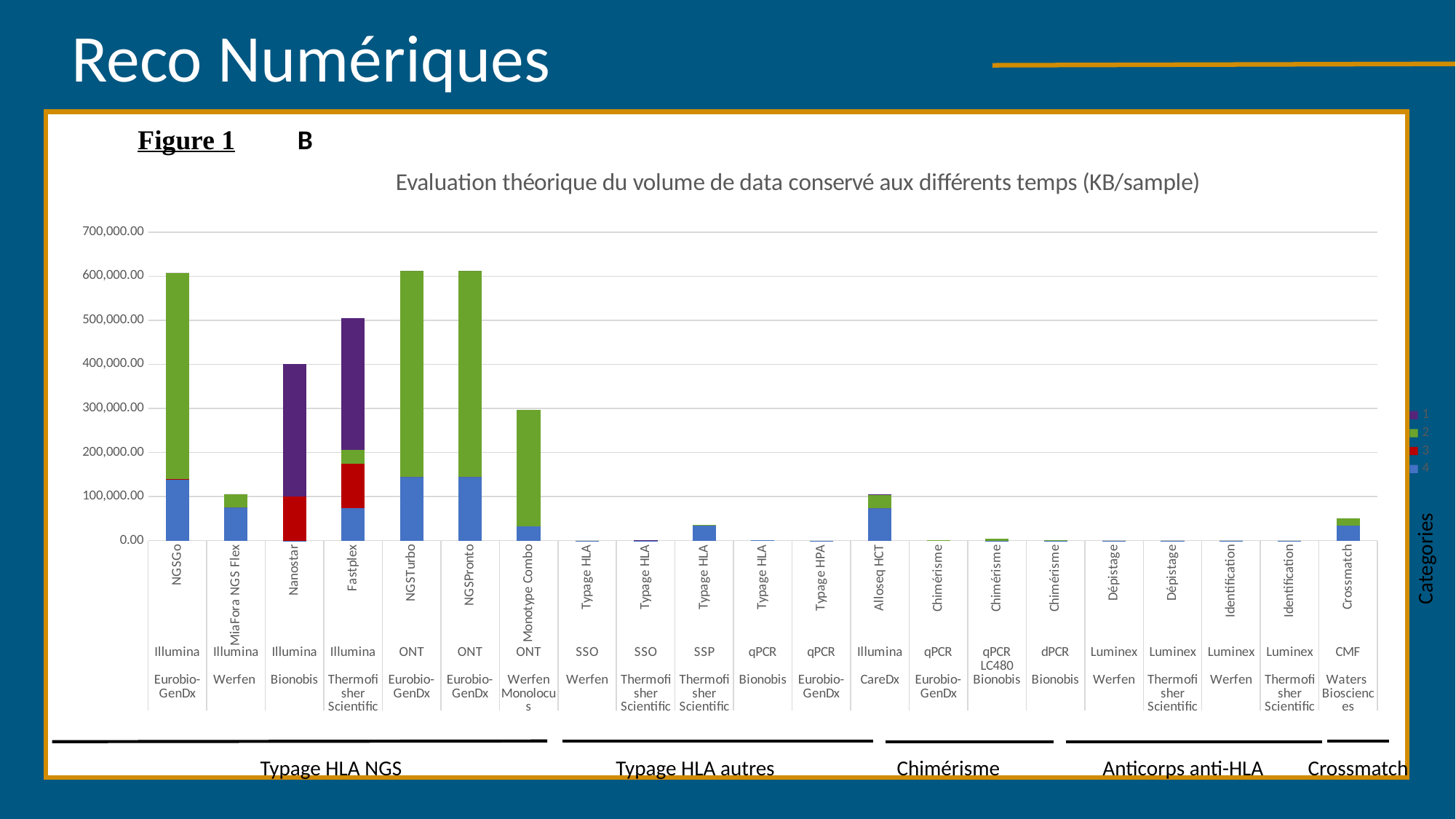
Is the total value for NGSGo greater or less than 500,000.00? greater Which legend series is shown in green? 2 What is the title of the chart? Evaluation théorique du volume de data conservé aux différents temps (KB/sample) Is the total value for Crossmatch greater or less than 100,000.00? less Is the total value for Fastplex greater or less than 400,000.00? greater Which has the larger total value, Nanostar or Monotype Combo? Nanostar How many bars (categories) are plotted along the x axis? 21 How many series does the legend list? 4 Which has the larger total value, Fastplex or Nanostar? Fastplex What kind of chart is shown on the slide? Stacked bar chart